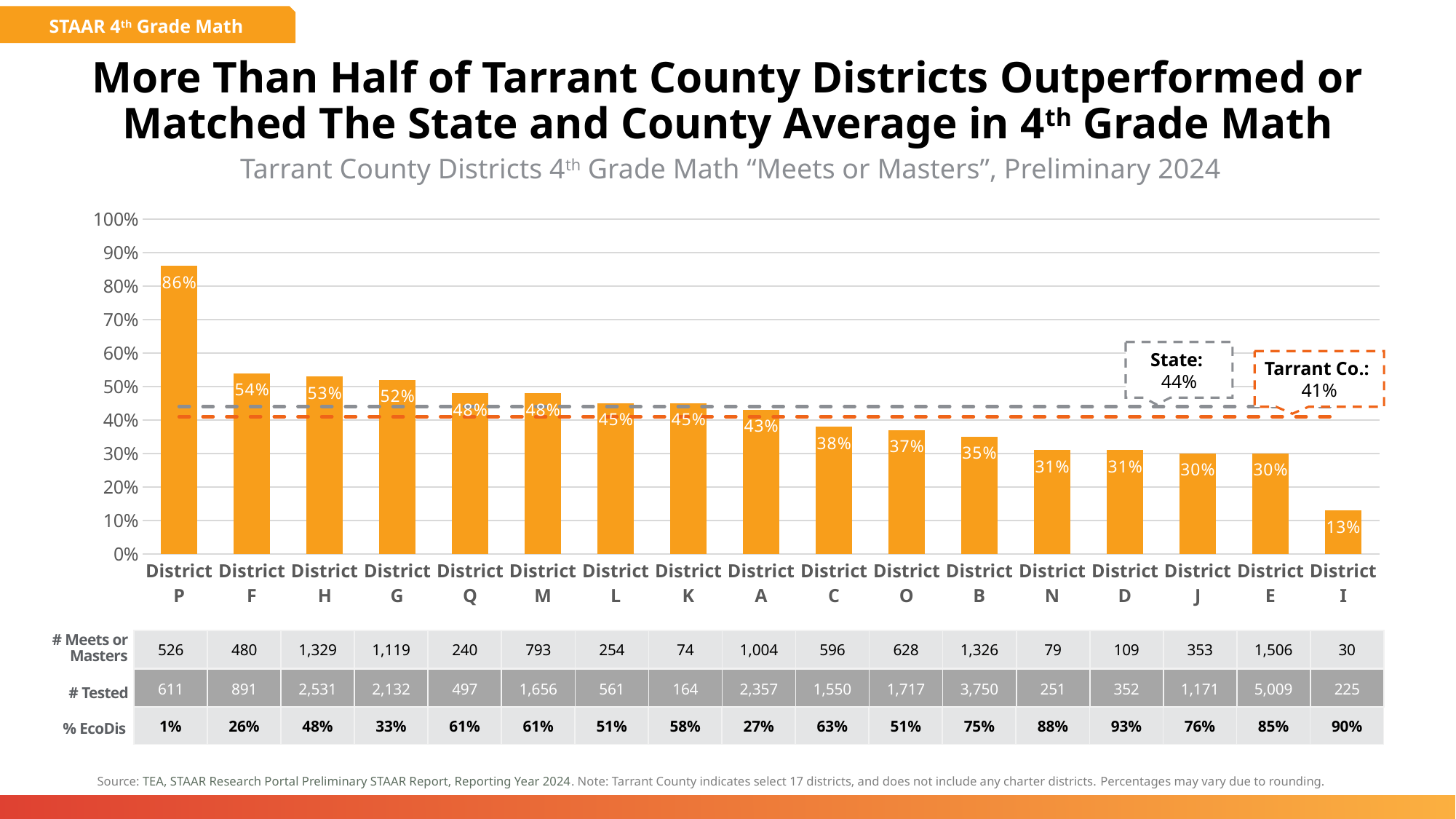
What is the Tarrant Co. average shown by the dashed line? 41% Do the bar values rise or fall from left to right along the x axis? Fall What is the difference between the values for District A and District I? 30% What is the difference between the values for District P and District F? 32% Which district has the highest value? District P What is the State average shown by the dashed line? 44% What is the value for District P? 86% Which is larger, the value for District H or the value for District B? District H What is the value for District C? 38% Which district has the lowest value? District I What kind of chart is this? Bar chart How many districts are shown on the chart? 17